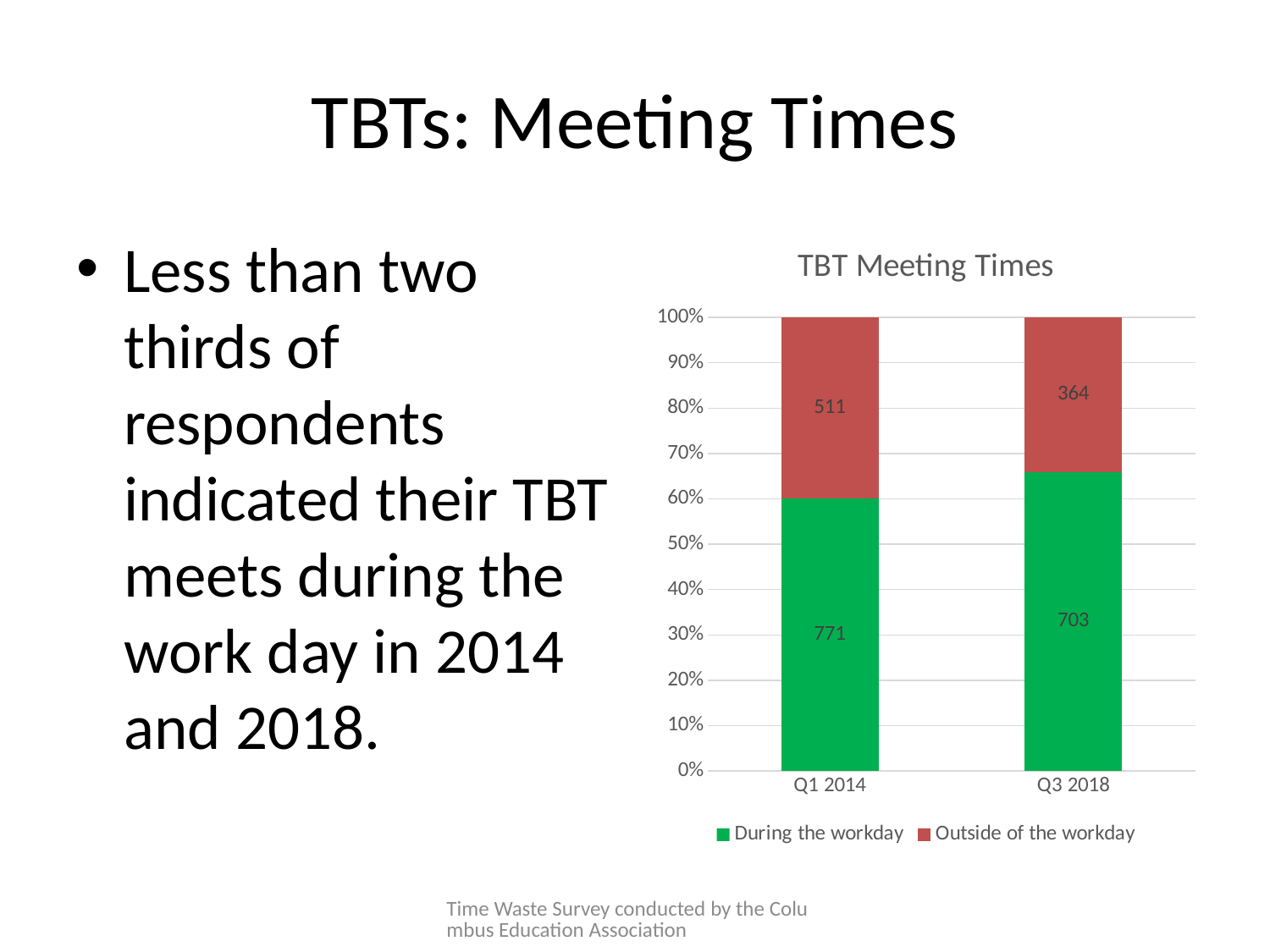
What is the total of the two series for Q3 2018? 1067 What is the value for 'During the workday' in Q1 2014? 771 Is the 'During the workday' share for Q3 2018 greater or less than 60%? greater What type of chart is shown? Stacked bar chart How many categories are shown on the x axis? 2 What is the value for 'Outside of the workday' in Q1 2014? 511 What is the value for 'During the workday' in Q3 2018? 703 Which is larger: 'Outside of the workday' in Q1 2014 or in Q3 2018? Q1 2014 How many series does the legend list? 2 What is the value for 'Outside of the workday' in Q3 2018? 364 What is the total of the two series for Q1 2014? 1282 What is the difference between the 'During the workday' values for Q1 2014 and Q3 2018? 68